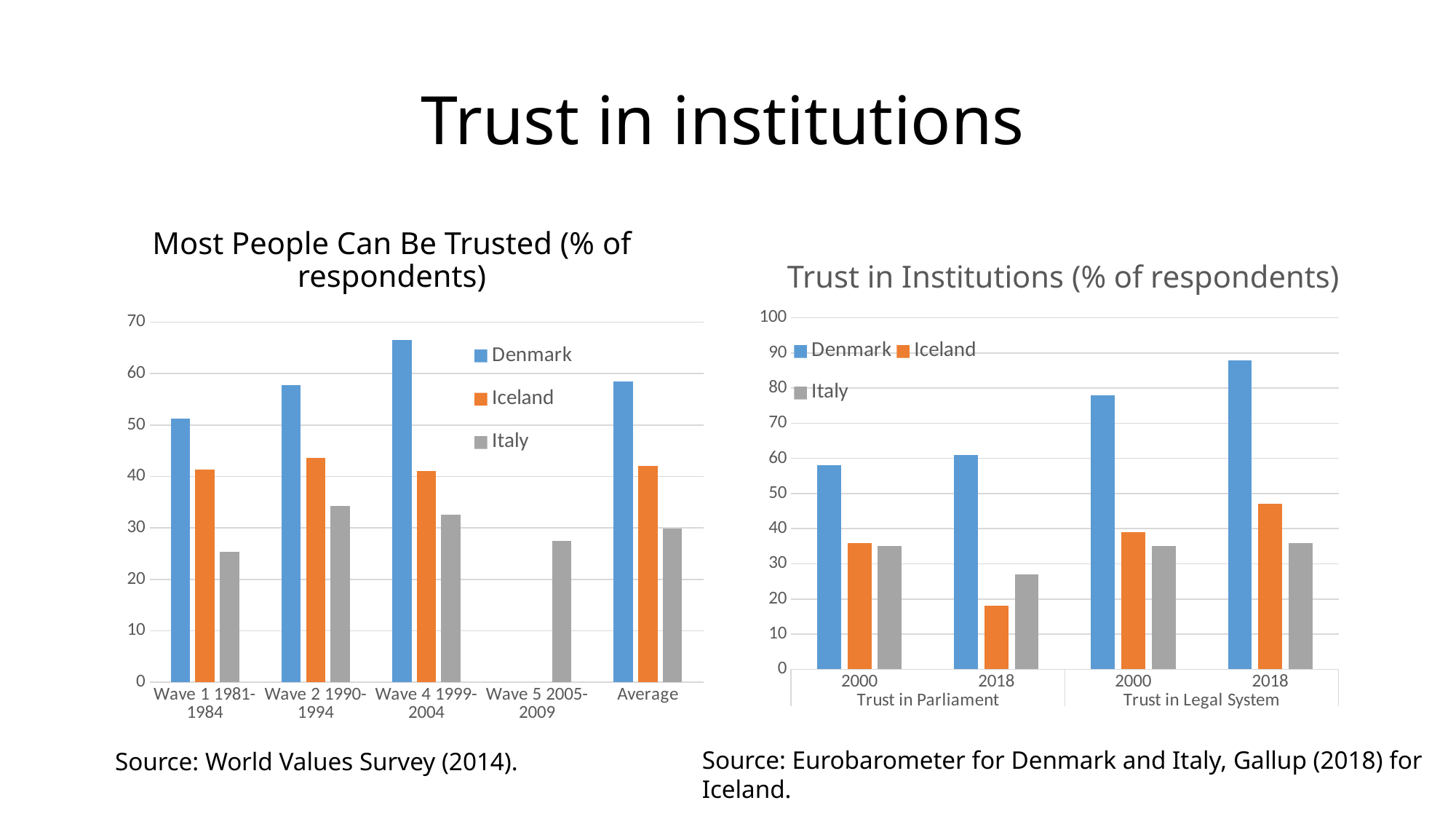
In the 'Trust in Institutions (% of respondents)' chart, is the Denmark value for 2018 Trust in Legal System greater or less than 80? greater In the 'Most People Can Be Trusted (% of respondents)' chart, which is larger for Wave 2 1990-1994: Iceland or Italy? Iceland What kind of chart is the 'Most People Can Be Trusted (% of respondents)' chart? bar chart In the 'Most People Can Be Trusted (% of respondents)' chart, is the Italy value for Wave 1 1981-1984 greater or less than 30? less In the 'Trust in Institutions (% of respondents)' chart, which category has the highest Denmark value? 2018 Trust in Legal System How many series does the legend of the 'Trust in Institutions (% of respondents)' chart list? 3 In the 'Trust in Institutions (% of respondents)' chart, does the Iceland value for Trust in Parliament rise or fall from 2000 to 2018? fall In the 'Most People Can Be Trusted (% of respondents)' chart, which country is shown in orange? Iceland How many categories are shown on the x axis of the 'Most People Can Be Trusted (% of respondents)' chart? 5 In the 'Most People Can Be Trusted (% of respondents)' chart, in which category is the Denmark value highest? Wave 4 1999-2004 How many series does the legend of the 'Most People Can Be Trusted (% of respondents)' chart list? 3 In the 'Trust in Institutions (% of respondents)' chart, which category has the lowest Iceland value? 2018 Trust in Parliament